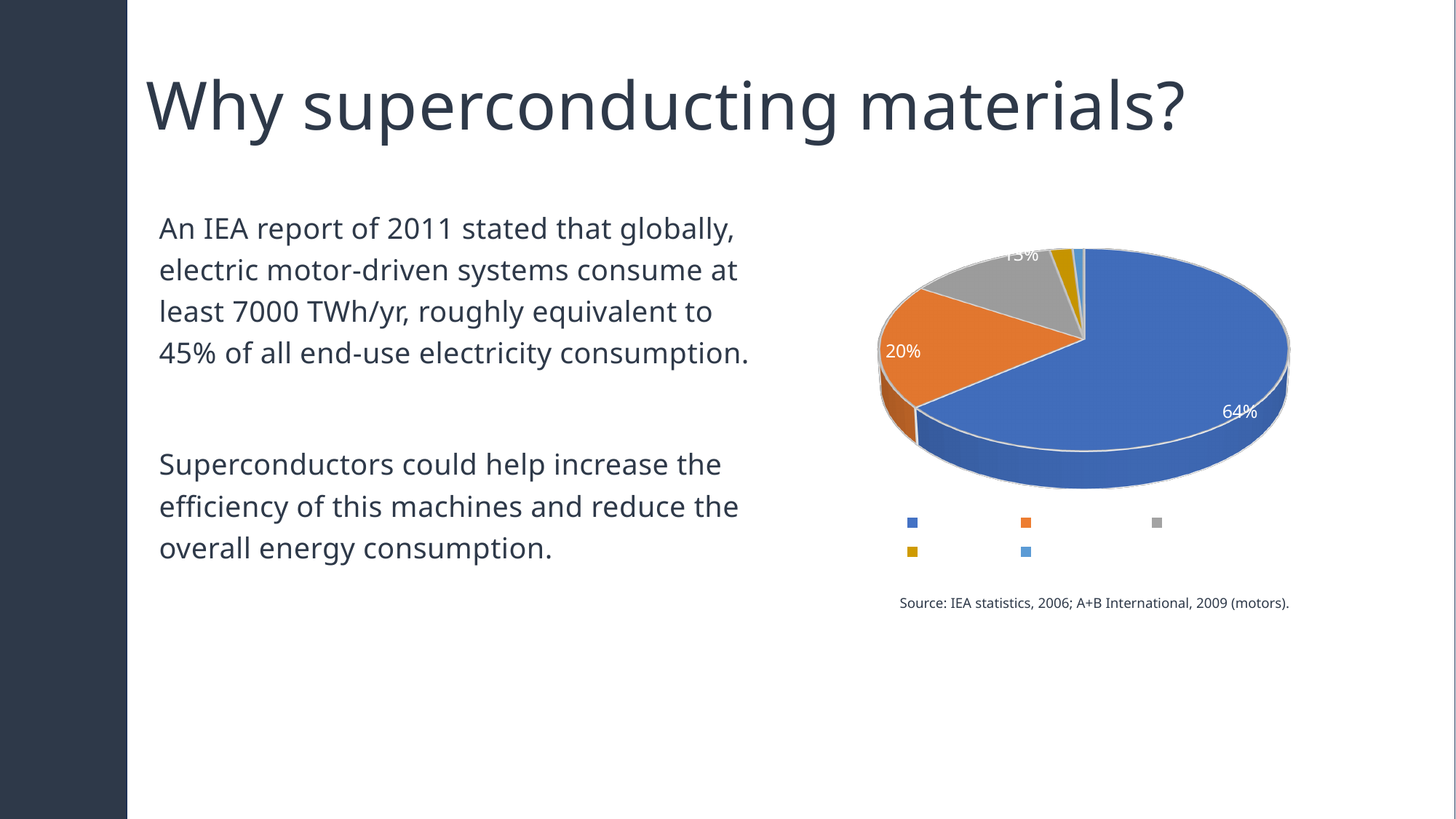
What source is cited below the pie chart? IEA statistics, 2006; A+B International, 2009 (motors). Is the orange slice of the pie chart greater or less than 25%? less What is the difference in percentage points between the blue slice (64%) and the orange slice (20%)? 44 What percentage is shown for the blue slice of the pie chart? 64% Which is larger in the pie chart, the blue slice or the orange slice? the blue slice Which colour slice is the largest in the pie chart? blue Is the pie chart drawn in 3D? yes Is the blue slice of the pie chart greater or less than 50%? greater What kind of chart is shown on the slide? pie chart How many entries (colour markers) does the legend of the pie chart show? 5 Which colour slice is the smallest clearly visible slice in the pie chart? yellow What percentage is shown for the orange slice of the pie chart? 20%